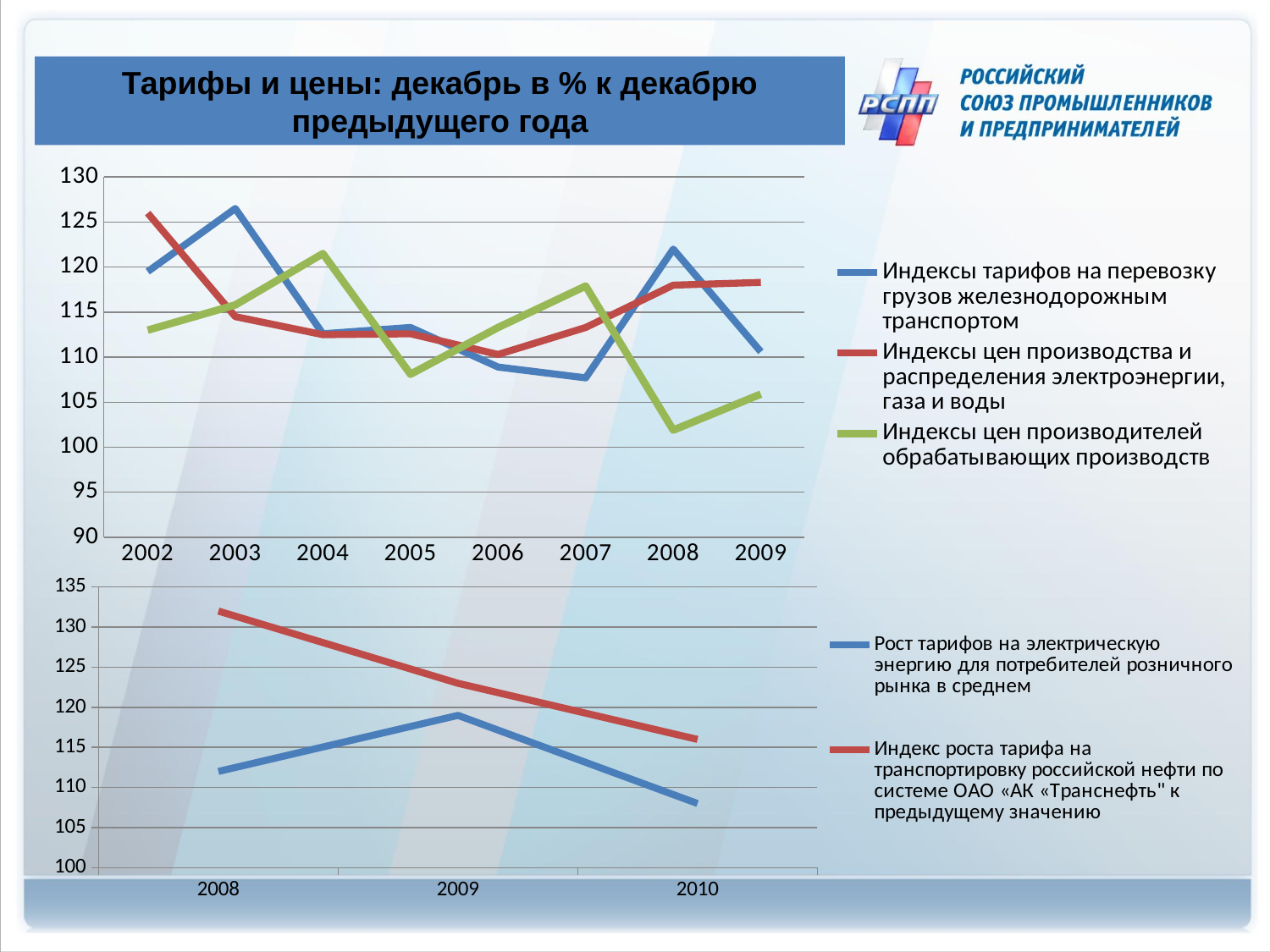
In the bottom chart, does the red series (Индекс роста тарифа на транспортировку российской нефти) rise or fall from 2008 to 2010? fall In the bottom chart, in which year does the blue series (Рост тарифов на электрическую энергию) reach its highest value? 2009 In the top chart, is the value of the blue series (Индексы тарифов на перевозку грузов железнодорожным транспортом) in 2003 greater or less than 120? greater How many series does the legend of the bottom chart list? 2 In the top chart, in which year does the green series (Индексы цен производителей обрабатывающих производств) reach its highest value? 2004 How many years are shown on the x axis of the top chart? 8 What kind of chart is the top chart on the slide? line chart How many series does the legend of the top chart list? 3 In the bottom chart, is the value of the blue series (Рост тарифов на электрическую энергию) in 2010 greater or less than 110? less How many years are shown on the x axis of the bottom chart? 3 In the bottom chart, which series has the larger value in 2010: the blue series (Рост тарифов на электрическую энергию) or the red series (Индекс роста тарифа на транспортировку российской нефти)? the red series In the top chart, is the value of the green series (Индексы цен производителей обрабатывающих производств) in 2008 greater or less than 105? less